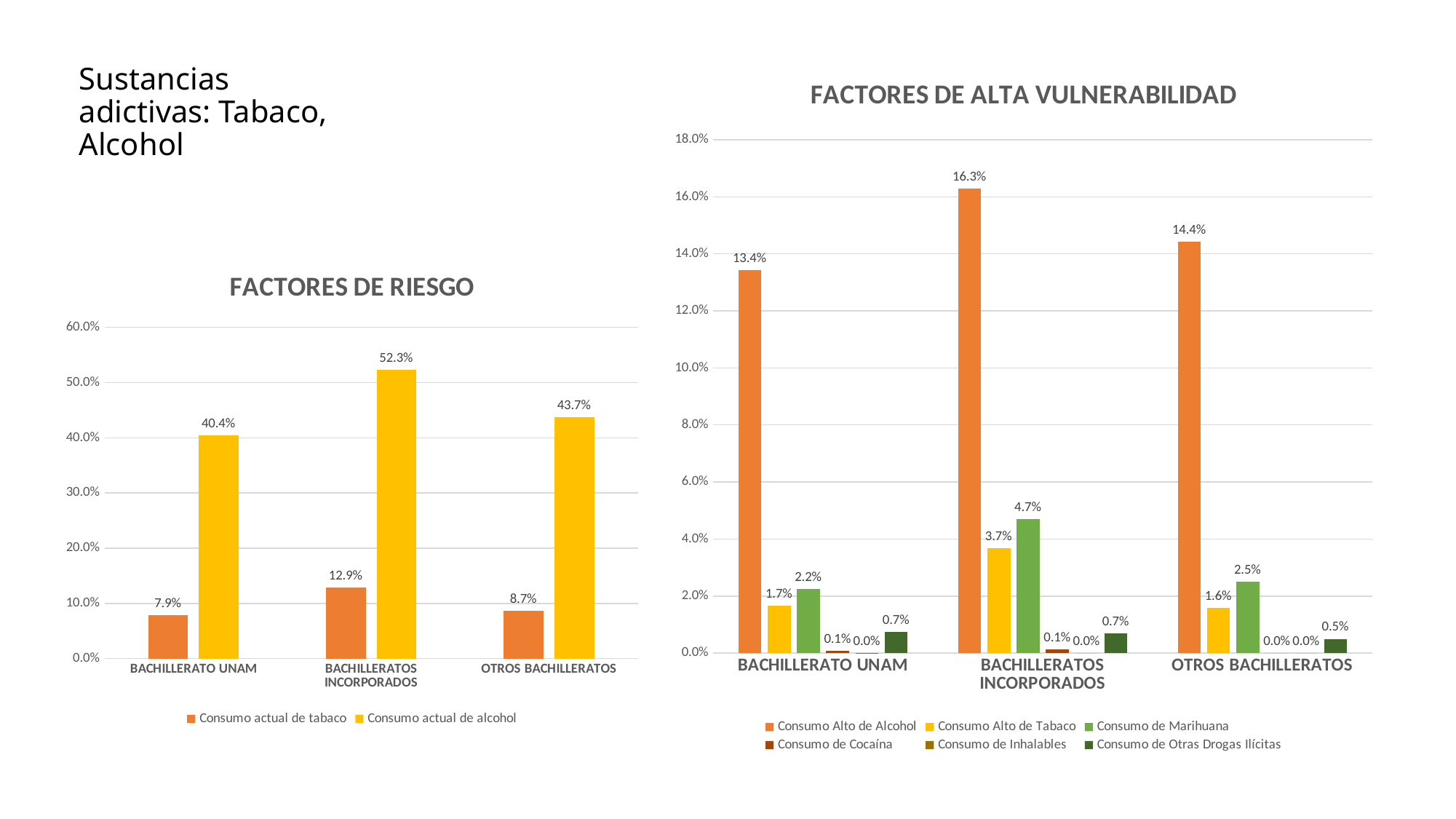
In the FACTORES DE ALTA VULNERABILIDAD chart, which is larger for BACHILLERATOS INCORPORADOS: Consumo Alto de Tabaco or Consumo de Marihuana? Consumo de Marihuana In the FACTORES DE ALTA VULNERABILIDAD chart, how many series does the legend list? 6 In the FACTORES DE ALTA VULNERABILIDAD chart, what is the value of Consumo de Marihuana for OTROS BACHILLERATOS? 2.5% In the FACTORES DE ALTA VULNERABILIDAD chart, what is the value of Consumo Alto de Alcohol for BACHILLERATOS INCORPORADOS? 16.3% In the FACTORES DE ALTA VULNERABILIDAD chart, how many categories are shown on the x axis? 3 In the FACTORES DE RIESGO chart, what is the value of Consumo actual de tabaco for BACHILLERATO UNAM? 7.9% In the FACTORES DE RIESGO chart, what is the value of Consumo actual de alcohol for BACHILLERATOS INCORPORADOS? 52.3% In the FACTORES DE RIESGO chart, what is the difference between Consumo actual de alcohol and Consumo actual de tabaco for OTROS BACHILLERATOS? 35.0% In the FACTORES DE ALTA VULNERABILIDAD chart, which category has the lowest Consumo Alto de Alcohol? BACHILLERATO UNAM In the FACTORES DE RIESGO chart, how many series does the legend list? 2 In the FACTORES DE RIESGO chart, which category has the highest Consumo actual de alcohol? BACHILLERATOS INCORPORADOS What kind of chart is FACTORES DE ALTA VULNERABILIDAD? Bar chart